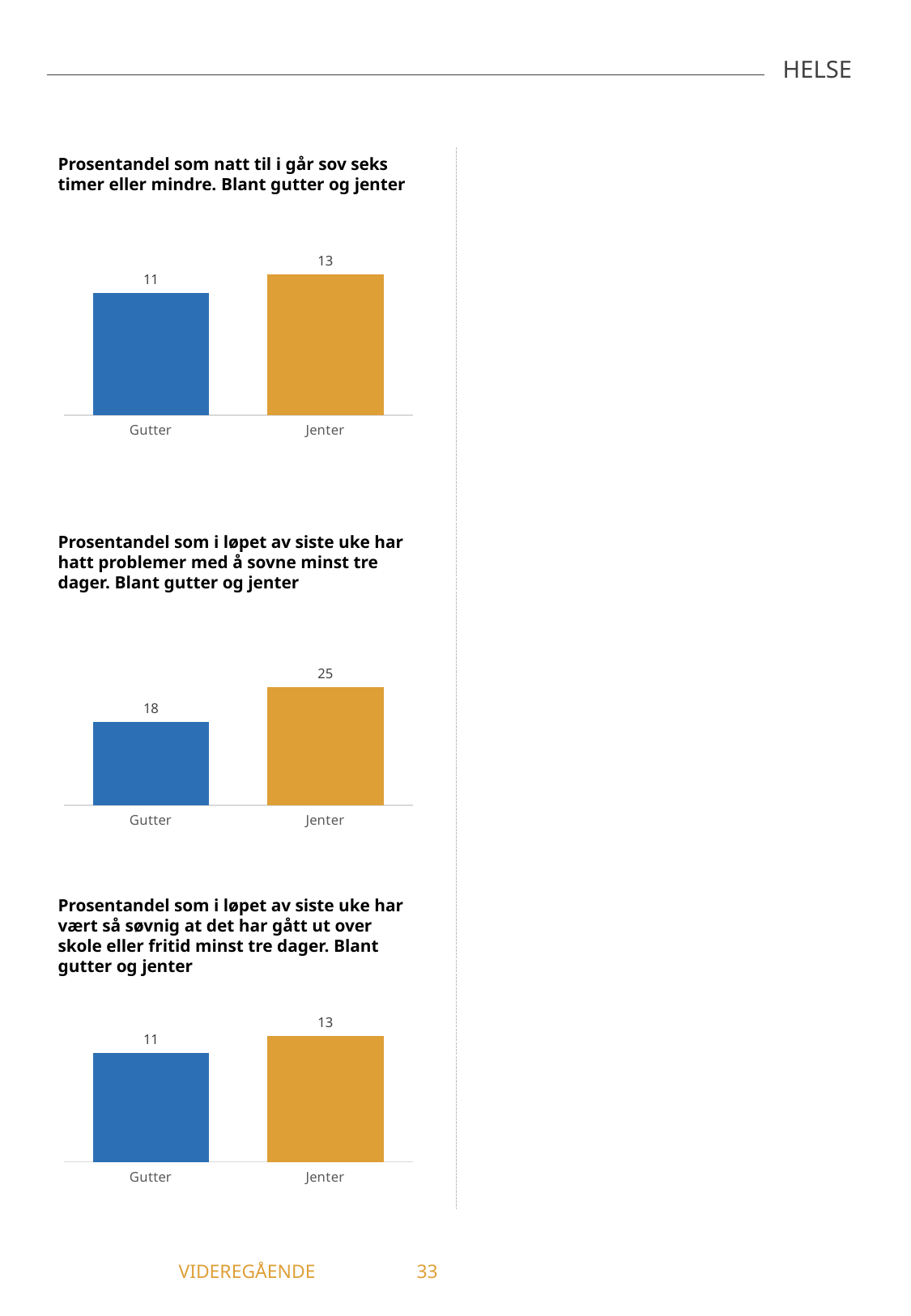
In the bottom chart (so sleepy it affected school or leisure), which category has the higher value? Jenter In the top chart (sleeping six hours or less), what is the value for Jenter? 13 In the bottom chart (so sleepy it affected school or leisure), what is the value for Gutter? 11 How many categories are shown in the bottom chart (so sleepy it affected school or leisure)? 2 In the middle chart (problems falling asleep at least three days), what is the difference between Jenter and Gutter? 7 In the middle chart (problems falling asleep at least three days), is the value for Gutter or Jenter larger? Jenter In the top chart (sleeping six hours or less), what is the value for Gutter? 11 What type of chart is the top chart (sleeping six hours or less)? Bar chart In the middle chart (problems falling asleep at least three days), what is the value for Gutter? 18 In the top chart (sleeping six hours or less), which category has the lower value? Gutter In the top chart (sleeping six hours or less), what is the difference between Jenter and Gutter? 2 In the middle chart (problems falling asleep at least three days), what is the value for Jenter? 25